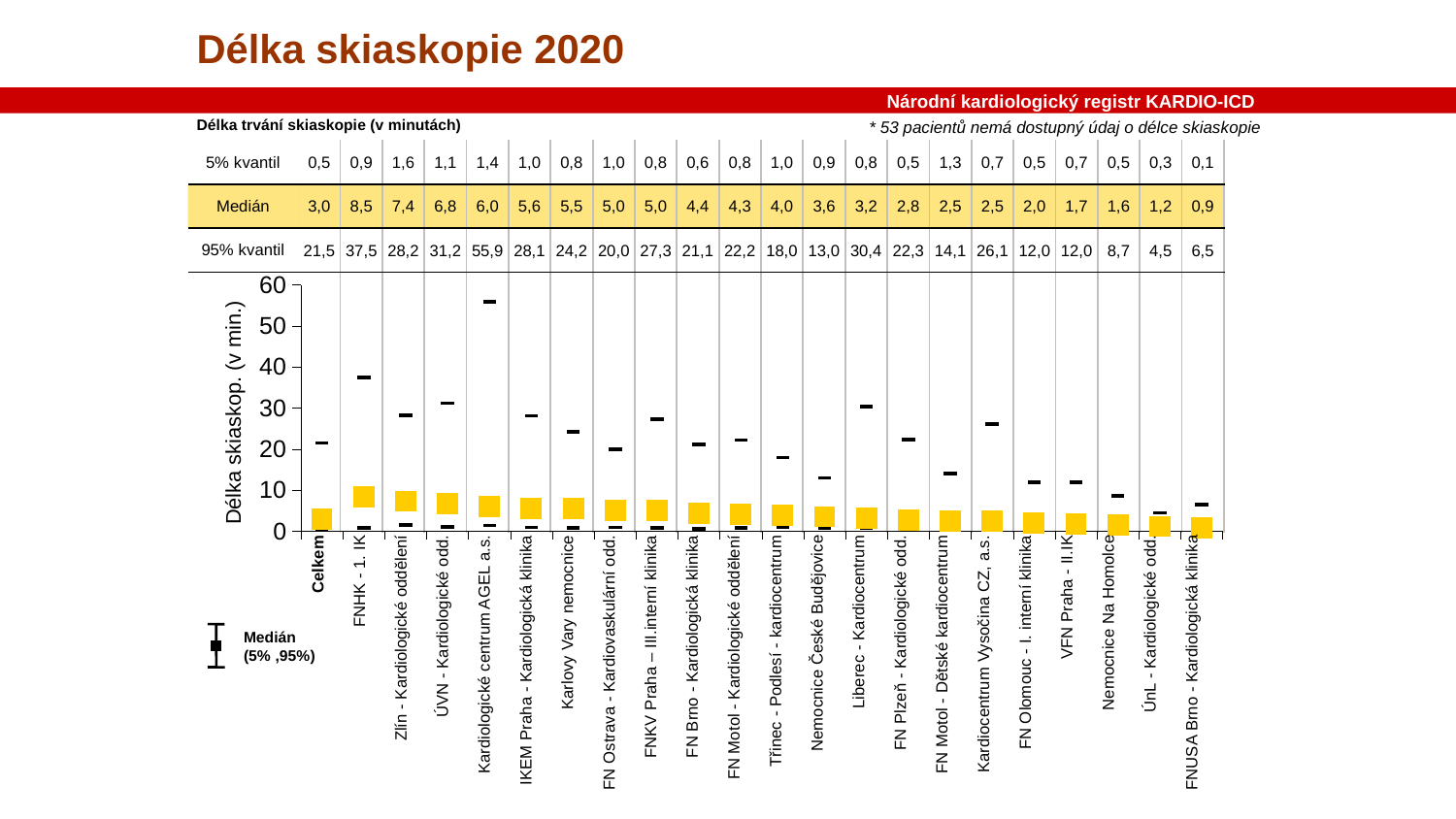
Which category has the lowest median (Medián) value? FNUSA Brno - Kardiologická klinika Which has the larger median: Zlín - Kardiologické oddělení or ÚVN - Kardiologické odd.? Zlín - Kardiologické oddělení Which category has the highest 95% kvantil value? Kardiologické centrum AGEL a.s. What is the 5% kvantil value for Celkem? 0,5 What is the difference between the 95% kvantil for Kardiologické centrum AGEL a.s. and for Celkem? 34,4 Do the median values rise or fall from FNHK - 1. IK to FNUSA Brno - Kardiologická klinika along the x axis? fall What is the label of the y axis? Délka skiaskop. (v min.) How many categories (including Celkem) are shown on the x axis? 22 Is the 95% kvantil value for FNHK - 1. IK greater or less than 30? greater What is the title of the slide? Délka skiaskopie 2020 What is the 95% kvantil value for Kardiologické centrum AGEL a.s.? 55,9 What is the median (Medián) length of skiaskopie for FNHK - 1. IK? 8,5